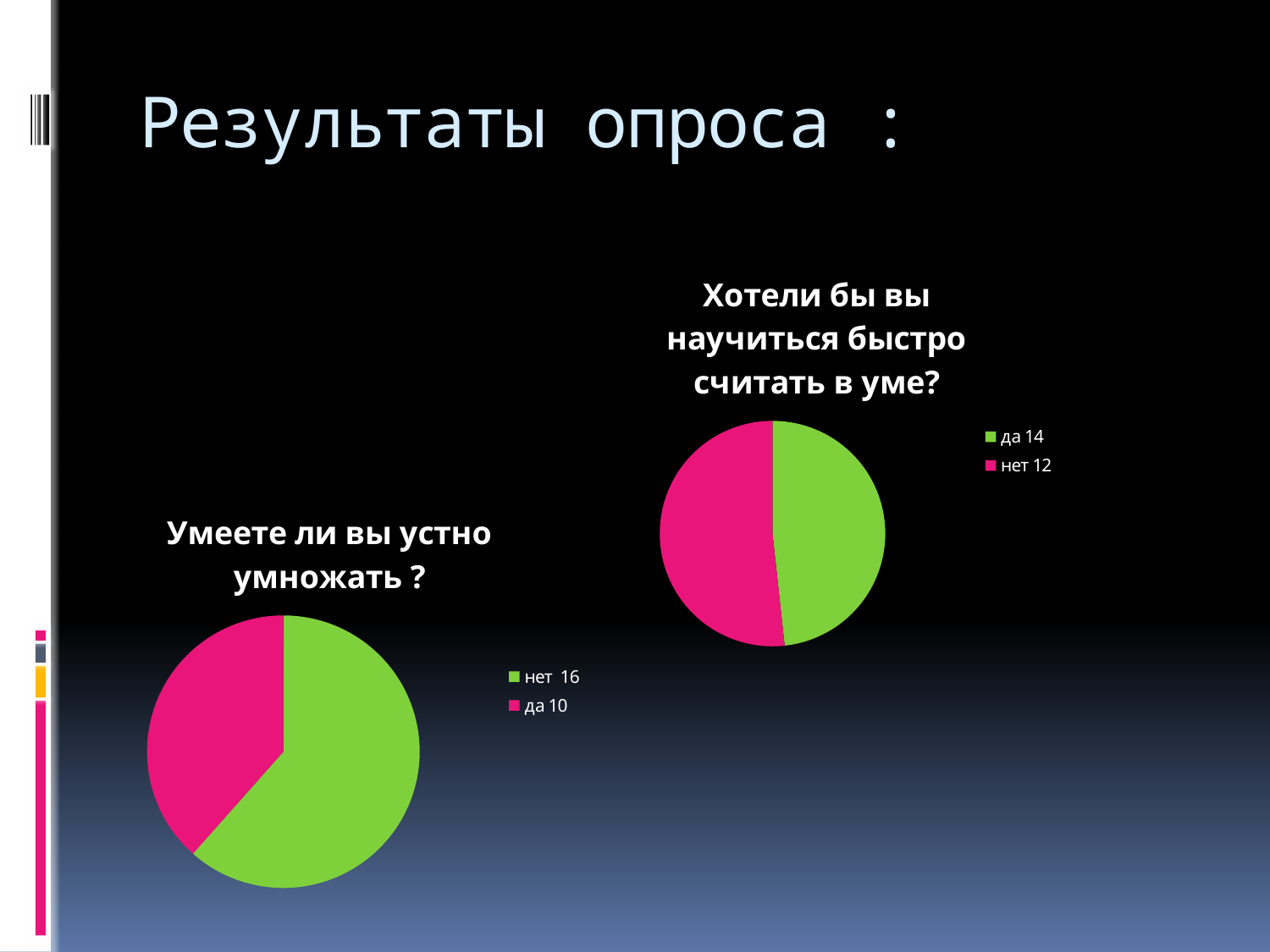
On the chart titled "Хотели бы вы научиться быстро считать в уме?", which is larger: "да" or "нет"? да On the chart titled "Хотели бы вы научиться быстро считать в уме?", how many respondents answered "нет"? 12 On the chart titled "Хотели бы вы научиться быстро считать в уме?", how many respondents answered "да"? 14 On the chart titled "Умеете ли вы устно умножать ?", how many respondents answered "да"? 10 On the chart titled "Умеете ли вы устно умножать ?", how many respondents answered "нет"? 16 On the chart titled "Умеете ли вы устно умножать ?", which answer has the larger slice? нет On the chart titled "Хотели бы вы научиться быстро считать в уме?", what is the difference between the "да" and "нет" counts? 2 What type of chart is the one titled "Умеете ли вы устно умножать ?"? pie chart On the chart titled "Умеете ли вы устно умножать ?", what is the difference between the "нет" and "да" counts? 6 On the chart titled "Умеете ли вы устно умножать ?", what colour is the "да" slice? pink How many entries does the legend of the chart titled "Хотели бы вы научиться быстро считать в уме?" list? 2